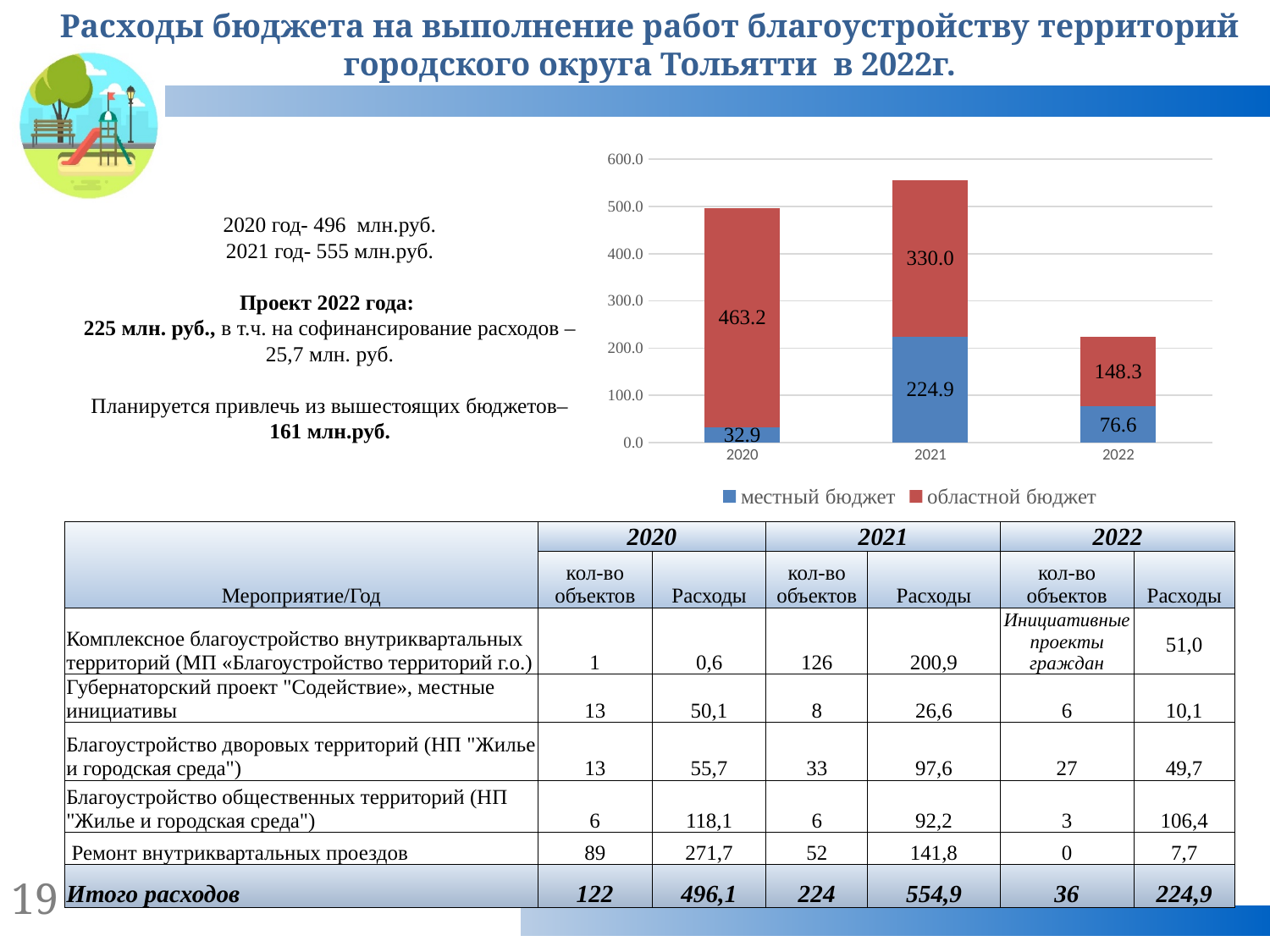
What is the value of областной бюджет for 2022? 148.3 Which is larger in 2021: местный бюджет or областной бюджет? областной бюджет What is the value of местный бюджет for 2021? 224.9 How many series does the legend list? 2 What is the value of областной бюджет for 2020? 463.2 What is the difference between областной бюджет and местный бюджет in 2022? 71.7 Which year has the highest value for областной бюджет? 2020 How many years are shown on the x axis of the chart? 3 What is the value of местный бюджет for 2020? 32.9 What type of chart is shown on the slide? stacked bar chart Which year has the lowest value for местный бюджет? 2020 What is the total of the stacked bar for 2021? 554.9